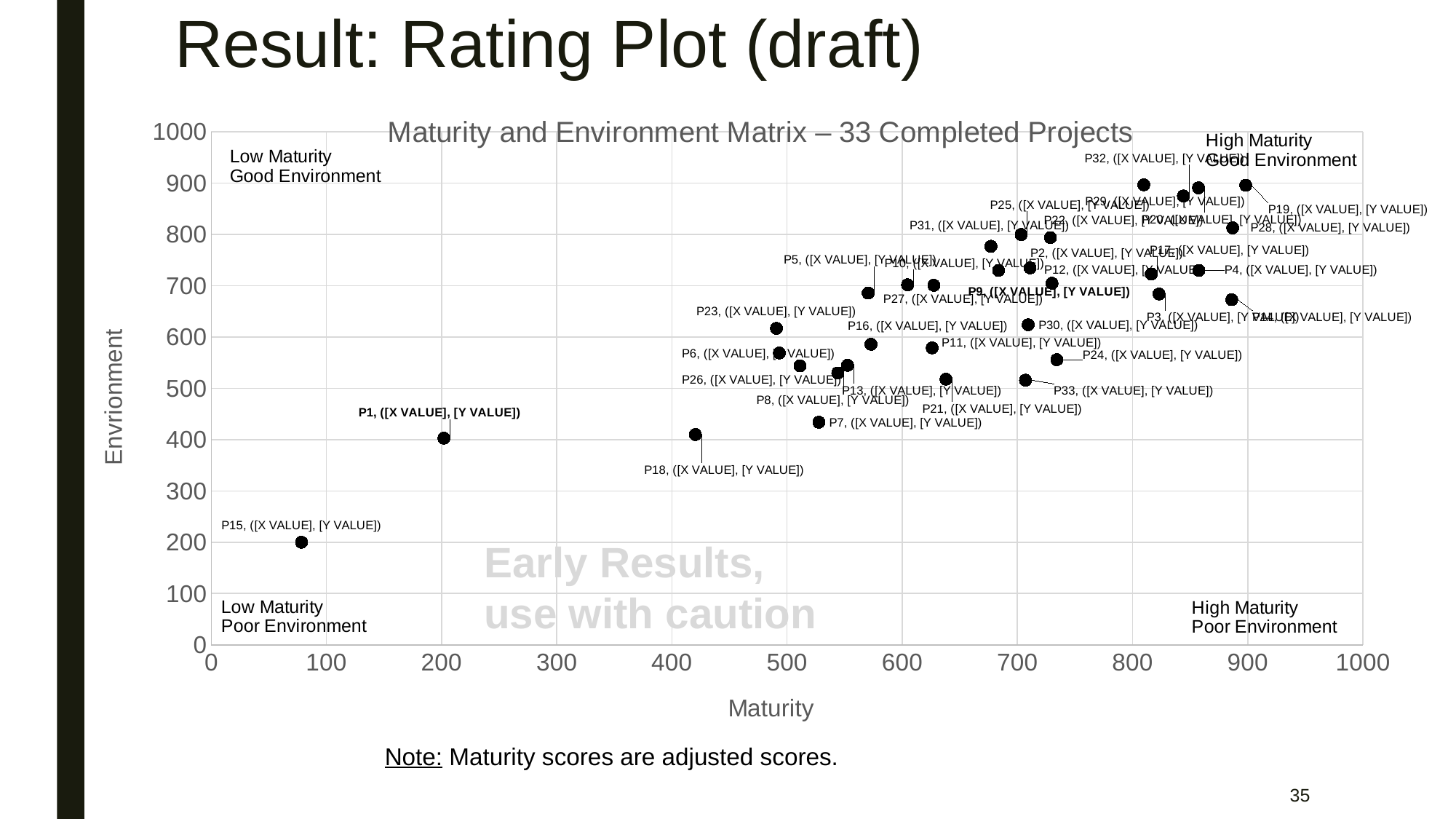
What are the labels of the x axis and the y axis of the chart? Maturity (x axis) and Environment (y axis) Which project has the lowest Maturity value? P15 Which project has the lowest Environment value? P15 Is the Maturity value for P1 greater or less than 300? less What is the title of the chart? Maturity and Environment Matrix – 33 Completed Projects What kind of chart is shown on the slide? scatter plot Do Environment values generally rise or fall as Maturity increases along the x axis? rise Which project has the higher Environment value, P1 or P15? P1 According to the chart title, how many completed projects are plotted? 33 Is the Environment value for P18 greater or less than 500? less Is the Environment value for P15 greater or less than 300? less